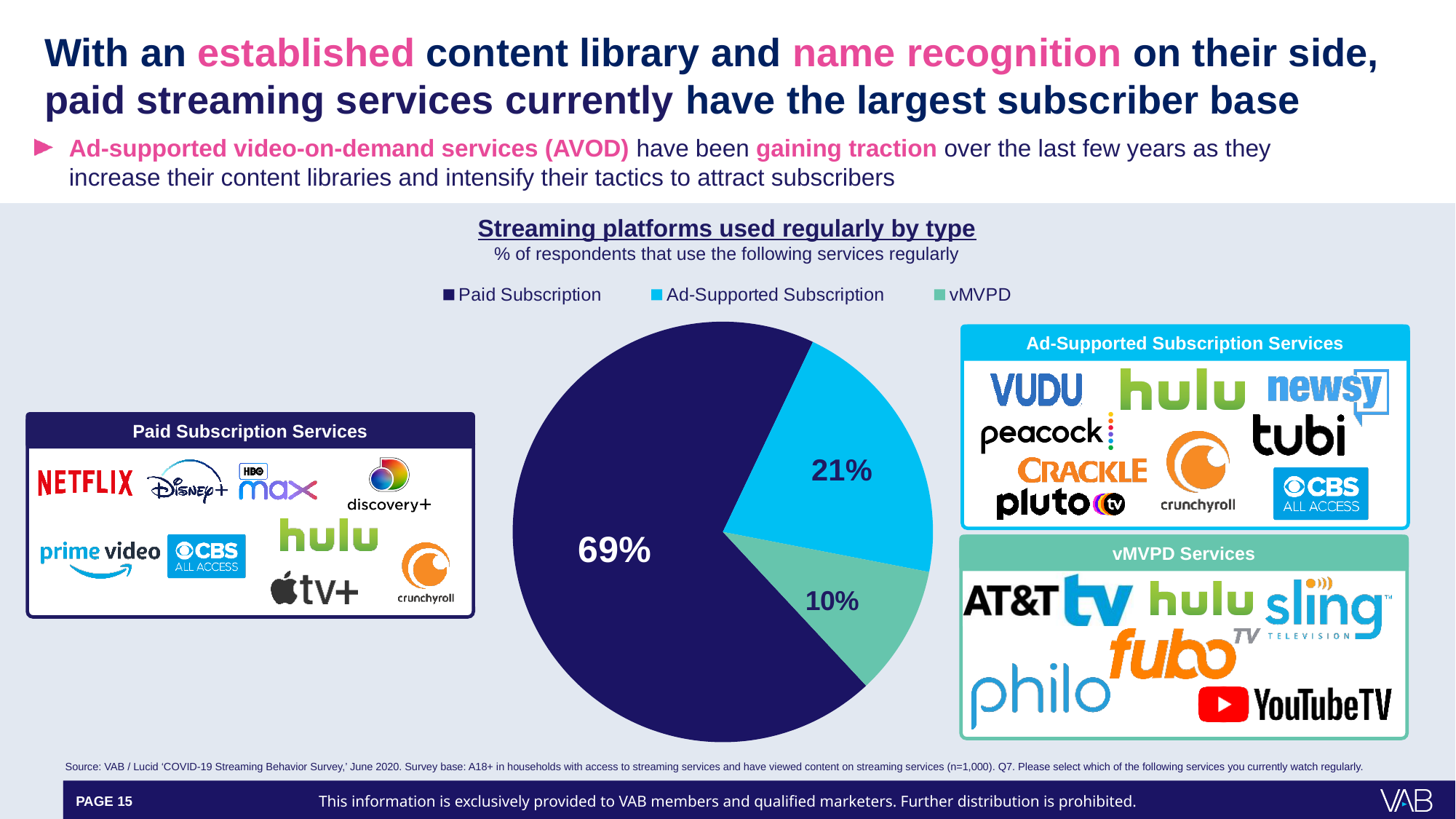
What is the difference in percentage points between Ad-Supported Subscription and vMVPD? 11 What kind of chart is shown on the slide? Pie chart Which is larger, the share for Ad-Supported Subscription or the share for vMVPD? Ad-Supported Subscription How many series does the legend list? 3 How many slices does the pie chart have? 3 Which streaming platform type has the smallest share of the pie? vMVPD What is the title of the chart? Streaming platforms used regularly by type What is the difference in percentage points between Paid Subscription and Ad-Supported Subscription? 48 What percentage of respondents regularly use vMVPD streaming platforms? 10% Which streaming platform type has the largest share of the pie? Paid Subscription What percentage of respondents regularly use Paid Subscription streaming platforms? 69% What percentage of respondents regularly use Ad-Supported Subscription streaming platforms? 21%